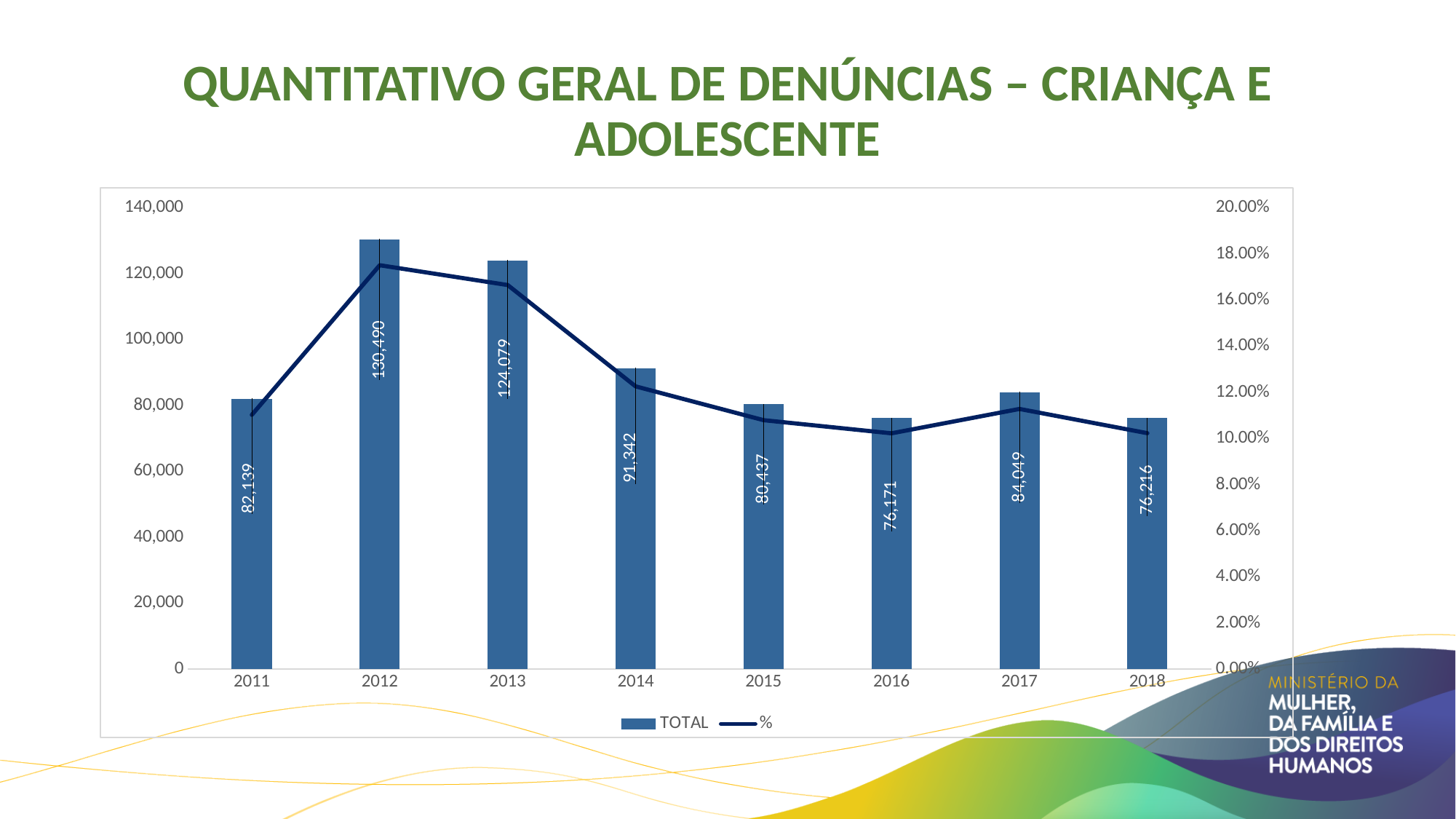
Which year has the lowest TOTAL? 2016 Does the TOTAL rise or fall from 2013 to 2016? fall Which is larger, the TOTAL for 2011 or the TOTAL for 2017? 2017 What is the TOTAL value for 2012? 130,490 Is the % value for 2016 greater or less than 12.00%? less What is the TOTAL value for 2016? 76,171 Is the % value for 2012 greater or less than 16.00%? greater What is the TOTAL value for 2014? 91,342 How many years are shown on the x axis? 8 How many series does the legend list? 2 Which year has the highest TOTAL? 2012 What is the difference between the TOTAL for 2012 and the TOTAL for 2013? 6,411